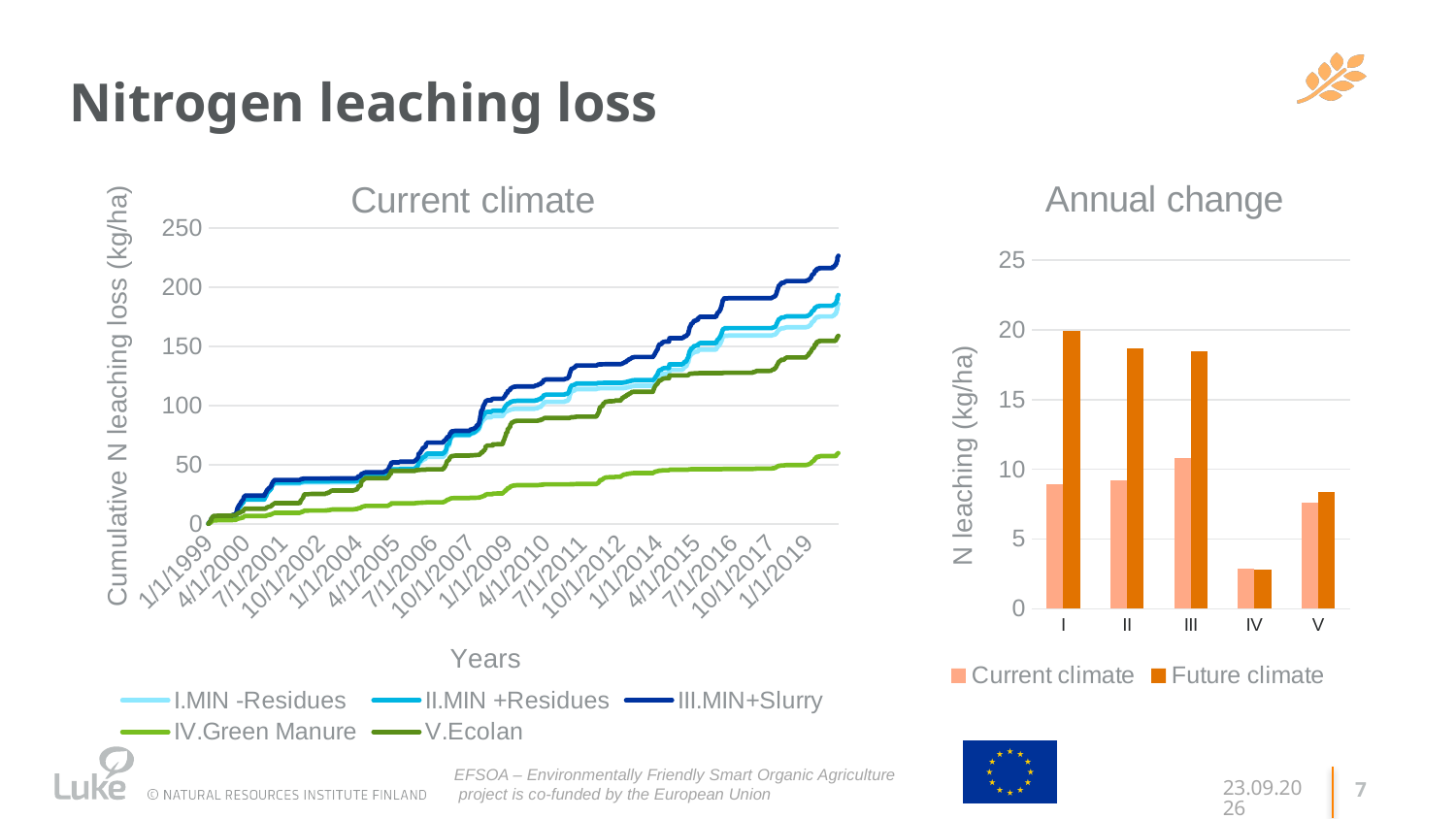
In the 'Annual change' chart, is the Future climate value for category I greater or less than 15? greater How many series does the legend of the 'Current climate' chart list? 5 In the 'Current climate' chart, do the cumulative N leaching loss values rise or fall over the years? rise How many categories are shown on the x axis of the 'Annual change' chart? 5 In the 'Annual change' chart, for category I, which is larger: the Current climate value or the Future climate value? Future climate What kind of chart is the 'Annual change' chart? bar chart In the 'Current climate' chart, which series has the lowest cumulative N leaching loss at the end of the period? IV.Green Manure What kind of chart is the 'Current climate' chart? line chart In the 'Current climate' chart, which series has the highest cumulative N leaching loss at the end of the period? III.MIN+Slurry In the 'Current climate' chart, is the final value for III.MIN+Slurry greater or less than 200? greater In the 'Annual change' chart, which category has the lowest Future climate value? IV How many series does the legend of the 'Annual change' chart list? 2